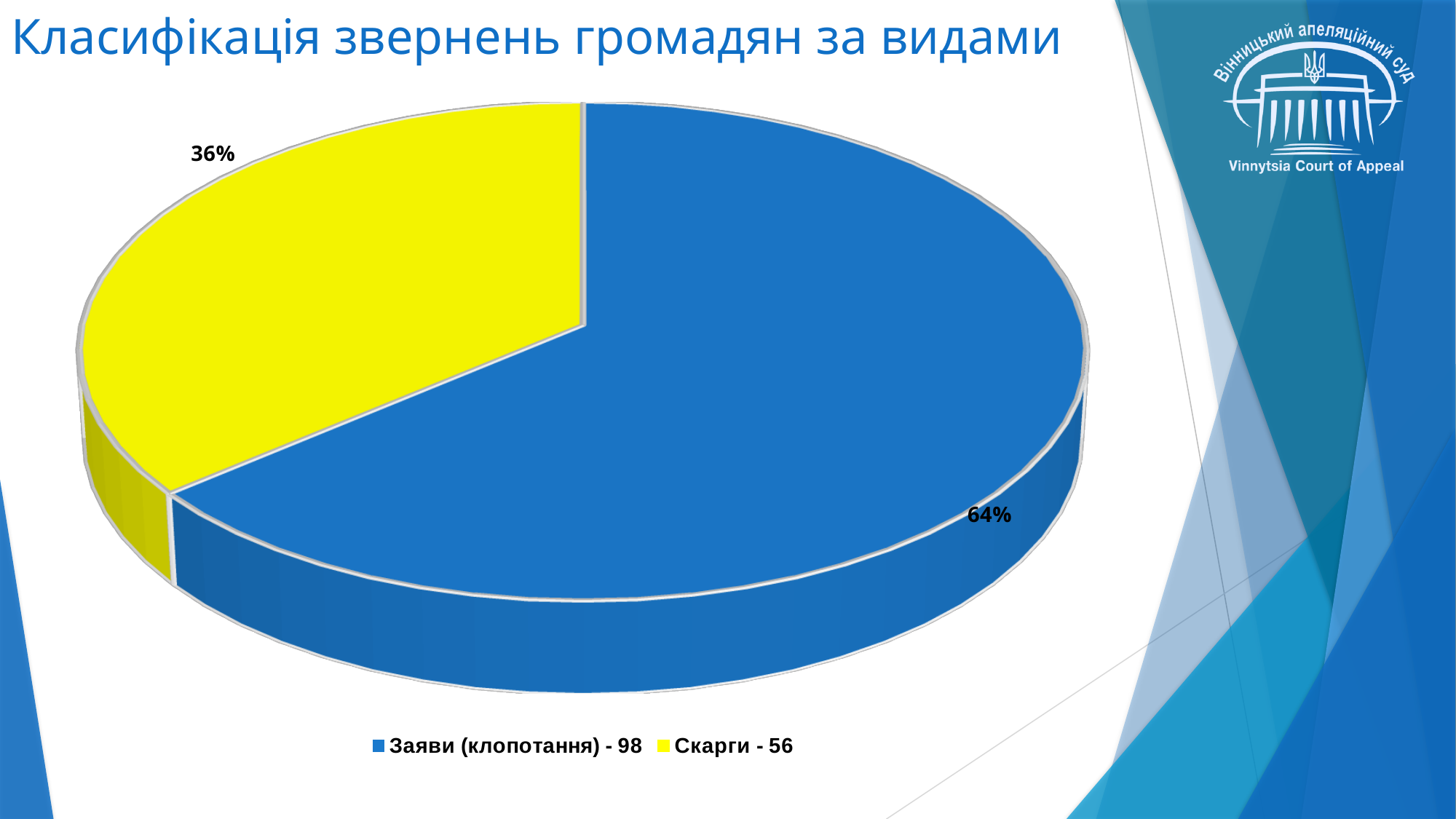
How many slices does the pie chart have? 2 What percentage share does the slice for Скарги - 56 have? 36% How many entries does the legend list? 2 Which is larger, the share for Заяви (клопотання) or the share for Скарги? Заяви (клопотання) What is the title of the chart on the slide? Класифікація звернень громадян за видами Which category has the smallest slice of the pie? Скарги - 56 Which category has the largest slice of the pie? Заяви (клопотання) - 98 What colour is the slice for Скарги - 56? yellow What kind of chart is shown on the slide? pie chart What is the difference in percentage points between the 64% slice and the 36% slice? 28 What percentage share does the slice for Заяви (клопотання) - 98 have? 64%